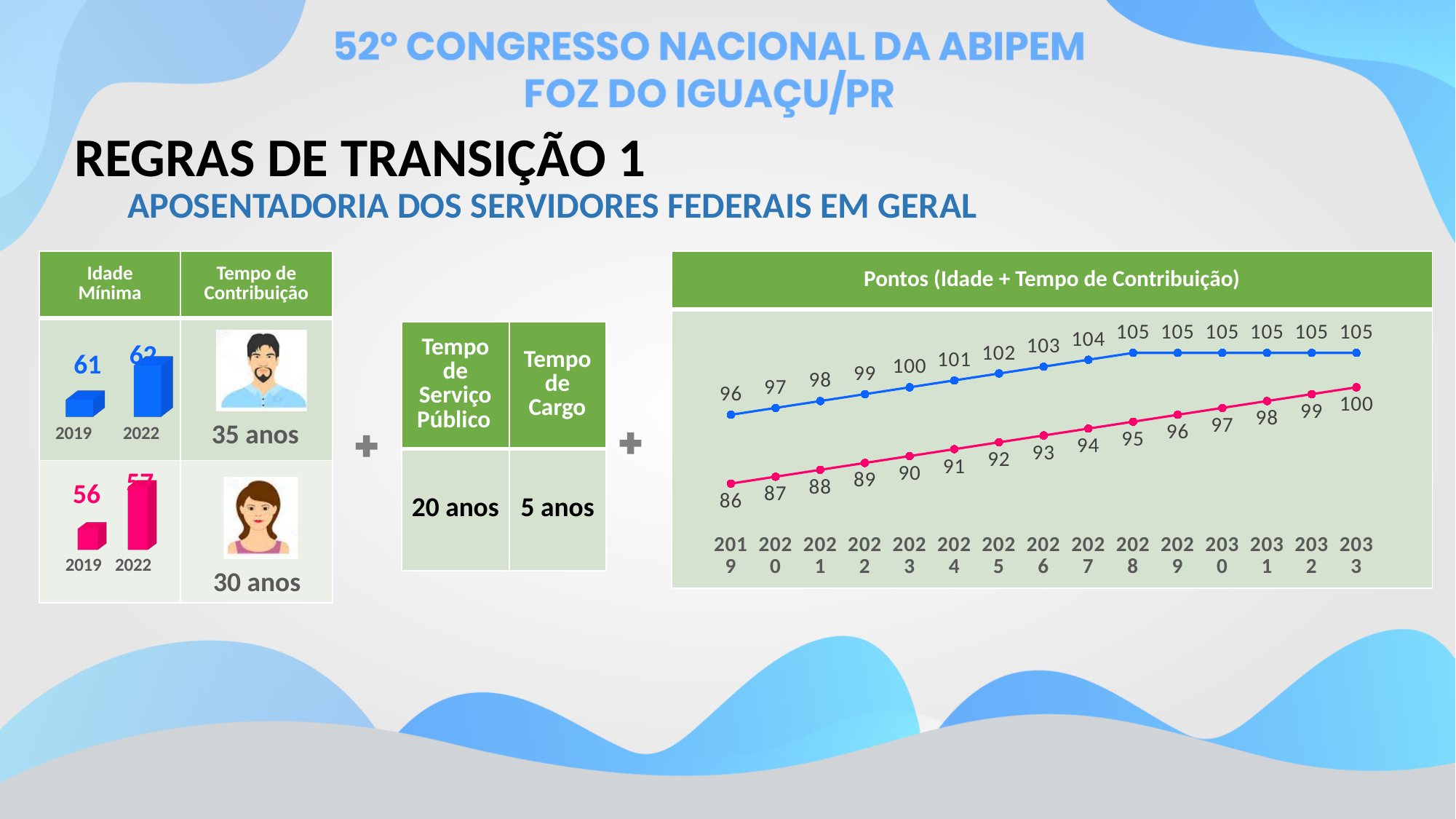
In the 'Pontos (Idade + Tempo de Contribuição)' chart, does the pink line rise or fall from 2019 to 2033? Rise In the 'Pontos (Idade + Tempo de Contribuição)' chart, what is the value of the blue line in 2019? 96 In the 'Pontos (Idade + Tempo de Contribuição)' chart, what is the value of the pink line in 2019? 86 In the 'Idade Mínima' bar chart on the left, what is the blue value for 2022? 62 In the 'Pontos (Idade + Tempo de Contribuição)' chart, how many years are shown on the x axis? 15 In the 'Pontos (Idade + Tempo de Contribuição)' chart, in which year does the blue line first reach 105? 2028 In the 'Idade Mínima' bar chart on the left, what is the pink value for 2019? 56 In the 'Pontos (Idade + Tempo de Contribuição)' chart, what is the difference between the blue and pink lines in 2019? 10 What kind of chart is 'Pontos (Idade + Tempo de Contribuição)'? Line chart In the 'Pontos (Idade + Tempo de Contribuição)' chart, what is the value of the blue line in 2028? 105 In the 'Pontos (Idade + Tempo de Contribuição)' chart, what is the difference between the blue line in 2033 and the blue line in 2019? 9 In the 'Pontos (Idade + Tempo de Contribuição)' chart, what is the value of the pink line in 2033? 100